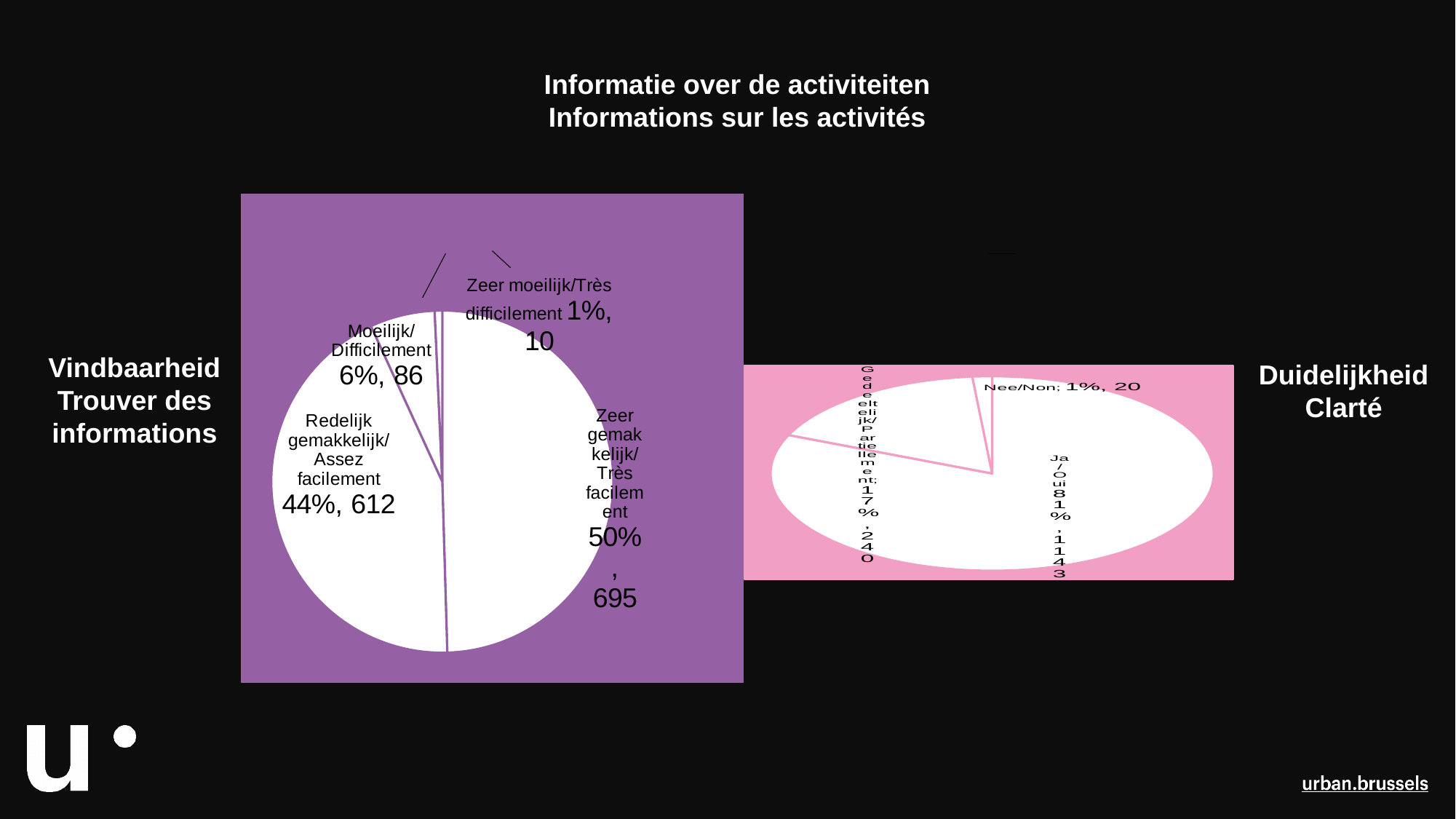
On the left chart (Vindbaarheid / Trouver des informations), what count is shown for 'Redelijk gemakkelijk/Assez facilement'? 612 What type of chart is used on the left (Vindbaarheid / Trouver des informations)? Pie chart On the left chart (Vindbaarheid / Trouver des informations), what percentage is shown for 'Zeer gemakkelijk/Très facilement'? 50% On the left chart (Vindbaarheid / Trouver des informations), which category has the largest share? Zeer gemakkelijk/Très facilement On the left chart (Vindbaarheid / Trouver des informations), which category has the smallest share? Zeer moeilijk/Très difficilement On the right chart (Duidelijkheid / Clarté), how many categories are shown? 3 On the right chart (Duidelijkheid / Clarté), what count is shown for 'Gedeeltelijk/Partiellement'? 240 On the left chart (Vindbaarheid / Trouver des informations), what is the difference in count between 'Zeer gemakkelijk/Très facilement' and 'Redelijk gemakkelijk/Assez facilement'? 83 On the right chart (Duidelijkheid / Clarté), what percentage is shown for 'Ja/Oui'? 81% On the left chart (Vindbaarheid / Trouver des informations), what count is shown for 'Moeilijk/Difficilement'? 86 On the right chart (Duidelijkheid / Clarté), what count is shown for 'Nee/Non'? 20 On the left chart (Vindbaarheid / Trouver des informations), how many categories are shown? 4